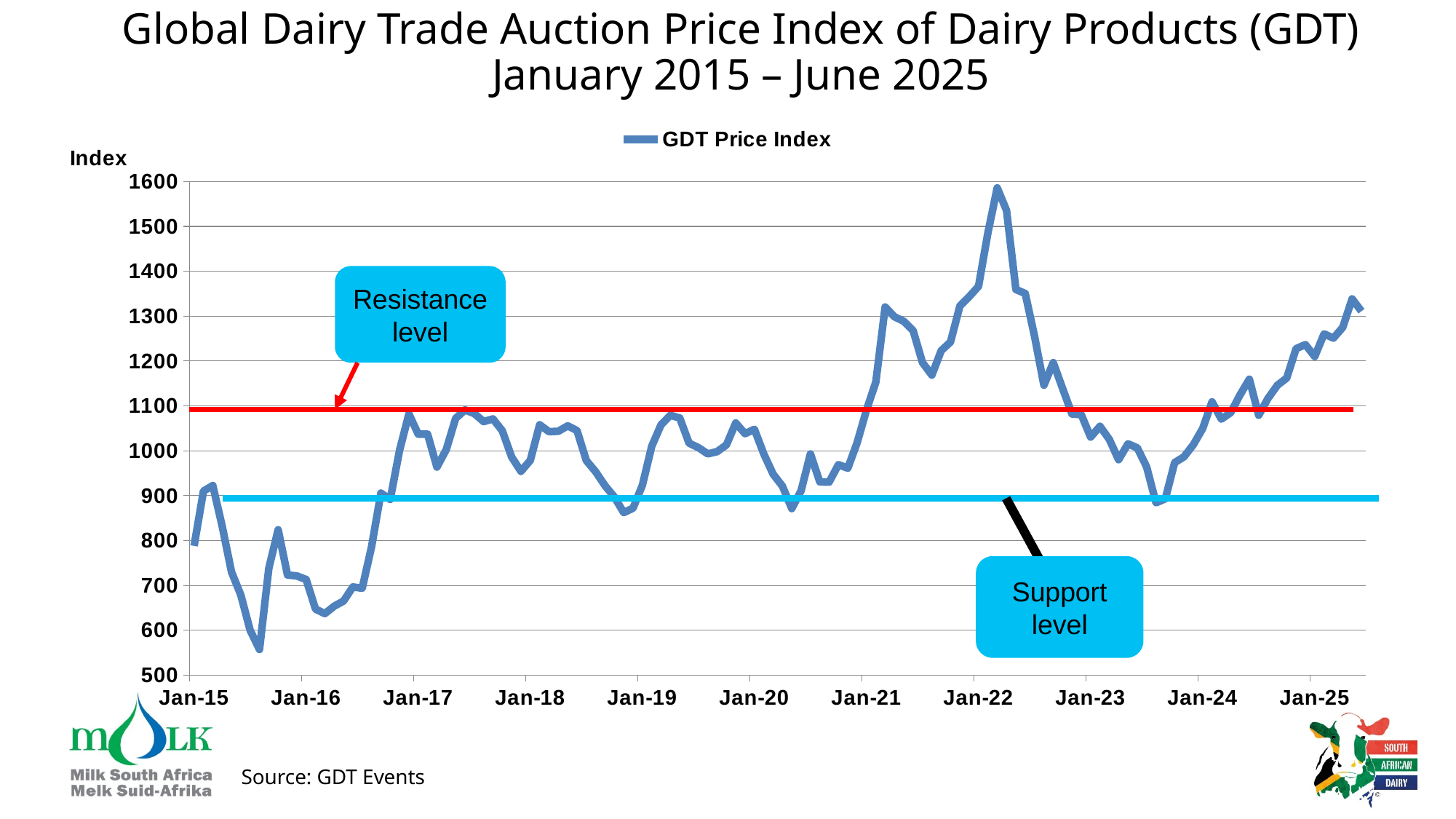
In which year does the GDT Price Index reach its highest point? 2022 Is the value of the GDT Price Index at Jan-25 greater or less than 1100? greater Is the highest peak of the GDT Price Index greater or less than 1500? greater What label is attached to the red horizontal line on the chart? Resistance level Is the GDT Price Index higher at Jan-22 or at Jan-23? Jan-22 Is the value of the GDT Price Index at Jan-19 greater or less than 1000? less From Jan-24 to Jan-25, does the GDT Price Index generally rise or fall? rise How many series does the legend list? 1 What is the name of the series shown in the legend? GDT Price Index What type of chart is shown on the slide? line chart